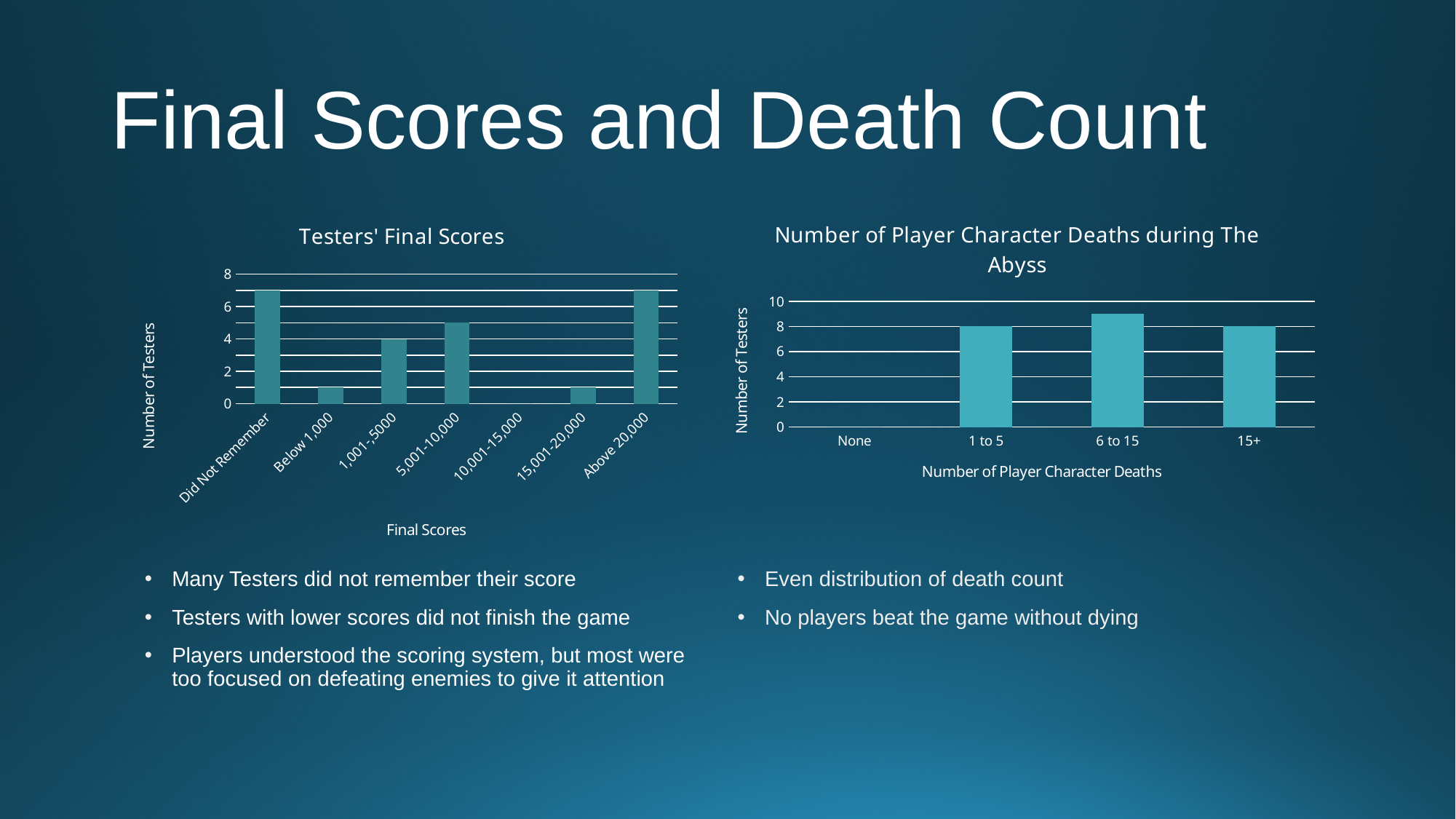
In the 'Testers' Final Scores' chart, is the value for 'Did Not Remember' greater or less than 6? greater In the 'Number of Player Character Deaths during The Abyss' chart, how many categories are shown on the x axis? 4 In the 'Testers' Final Scores' chart, how many testers scored 10,001-15,000? 0 In the 'Number of Player Character Deaths during The Abyss' chart, is the value for '6 to 15' greater or less than 8? greater In the 'Testers' Final Scores' chart, which score category has the lowest number of testers? 10,001-15,000 In the 'Testers' Final Scores' chart, how many testers scored 1,001-5,000? 4 In the 'Testers' Final Scores' chart, which has more testers: '5,001-10,000' or 'Below 1,000'? 5,001-10,000 In the 'Number of Player Character Deaths during The Abyss' chart, how many testers had no deaths (None)? 0 In the 'Testers' Final Scores' chart, how many score categories are shown on the x axis? 7 What kind of chart is the 'Testers' Final Scores' chart? bar chart In the 'Number of Player Character Deaths during The Abyss' chart, how many testers had 1 to 5 deaths? 8 In the 'Number of Player Character Deaths during The Abyss' chart, which category has the highest number of testers? 6 to 15